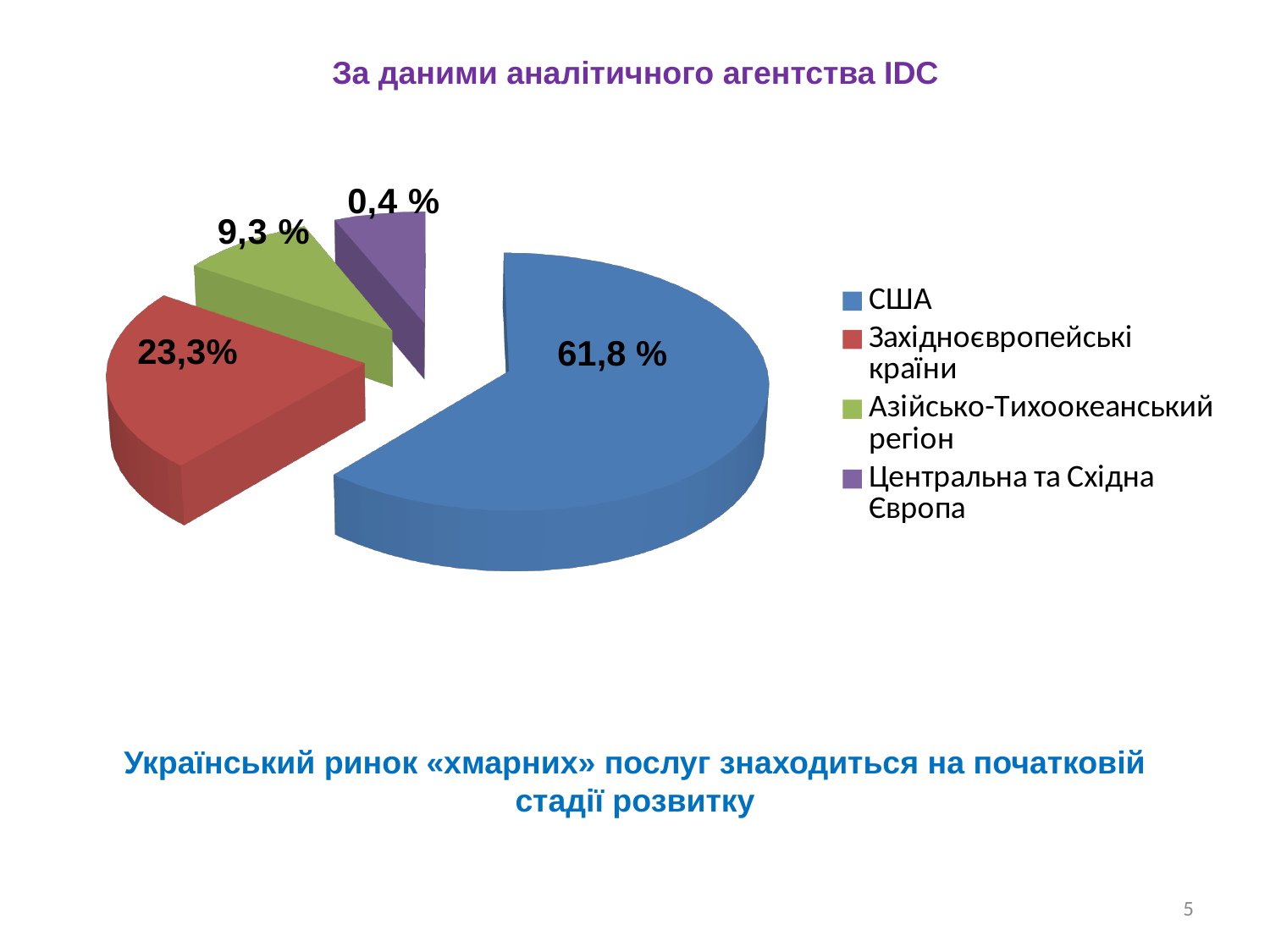
Which is larger, the slice for Західноєвропейські країни or the slice for Азійсько-Тихоокеанський регіон? Західноєвропейські країни Which category has the largest slice of the pie? США What value is shown for Західноєвропейські країни? 23,3% What kind of chart is shown on the slide? Pie chart What value is shown for Центральна та Східна Європа? 0,4 % What is the difference between the values for Азійсько-Тихоокеанський регіон and Центральна та Східна Європа? 8,9 % What is the difference between the values for США and Західноєвропейські країни? 38,5 % What value is shown for Азійсько-Тихоокеанський регіон? 9,3 % Which category has the smallest slice of the pie? Центральна та Східна Європа What share of the pie does США hold? 61,8 % What colour is the slice for США? Blue How many slices does the pie chart have? 4